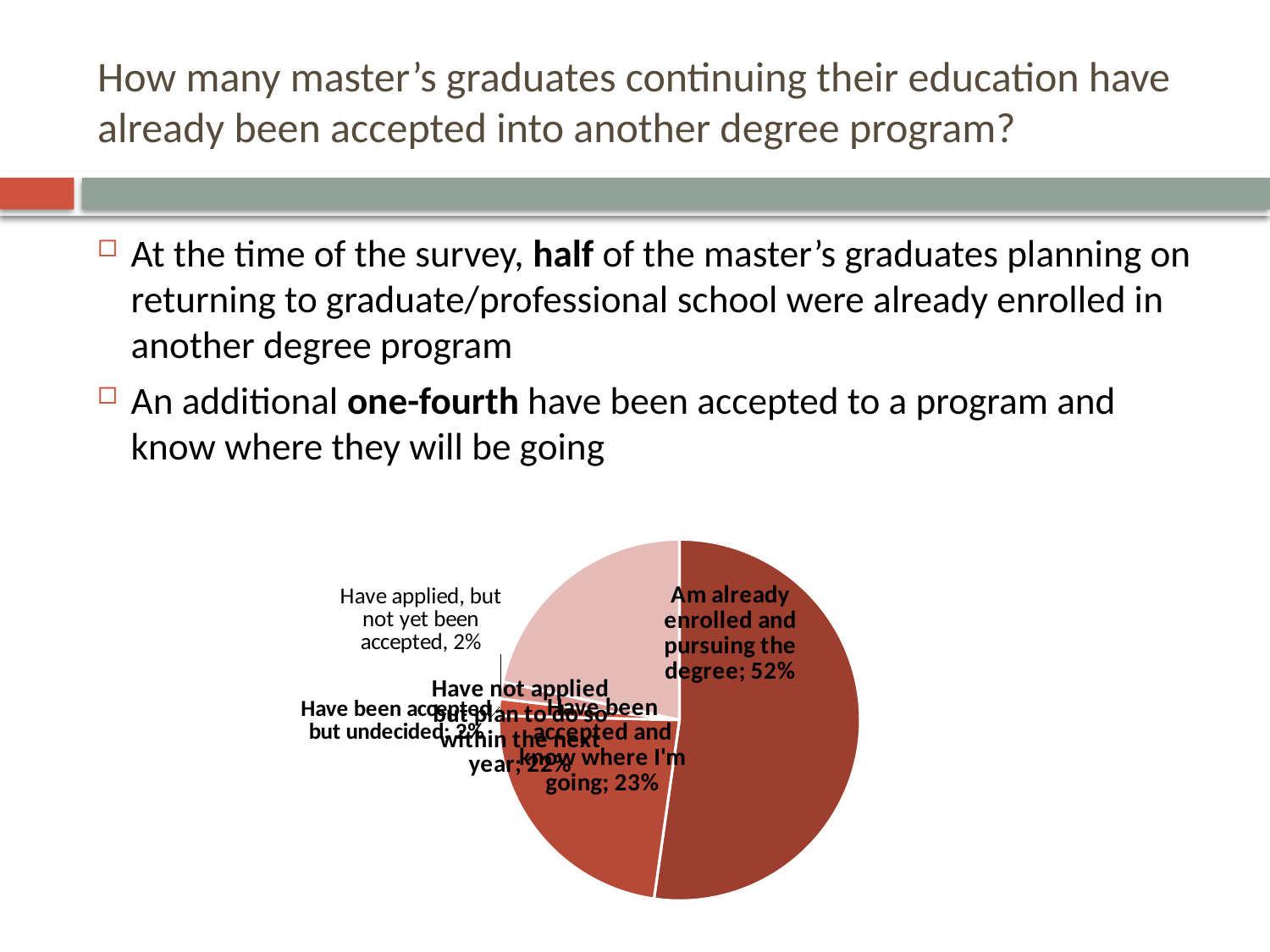
What percentage have been accepted and know where they are going? 23% Which category has the largest share of the pie? Am already enrolled and pursuing the degree Is the share of graduates already enrolled and pursuing the degree greater or less than 50%? greater How many slices does the pie chart have? 5 What is the combined share of those already enrolled and those accepted and knowing where they are going? 75% What is the difference in percentage points between those already enrolled (52%) and those accepted and knowing where they are going (23%)? 29 What kind of chart is shown on the slide? pie chart What percentage of master's graduates are already enrolled and pursuing the degree? 52% What percentage have been accepted but are undecided? 2% What percentage have applied but not yet been accepted? 2% Which is larger: the share who have been accepted and know where they are going, or the share who have not applied but plan to do so within the next year? Have been accepted and know where I'm going What percentage have not applied but plan to do so within the next year? 22%